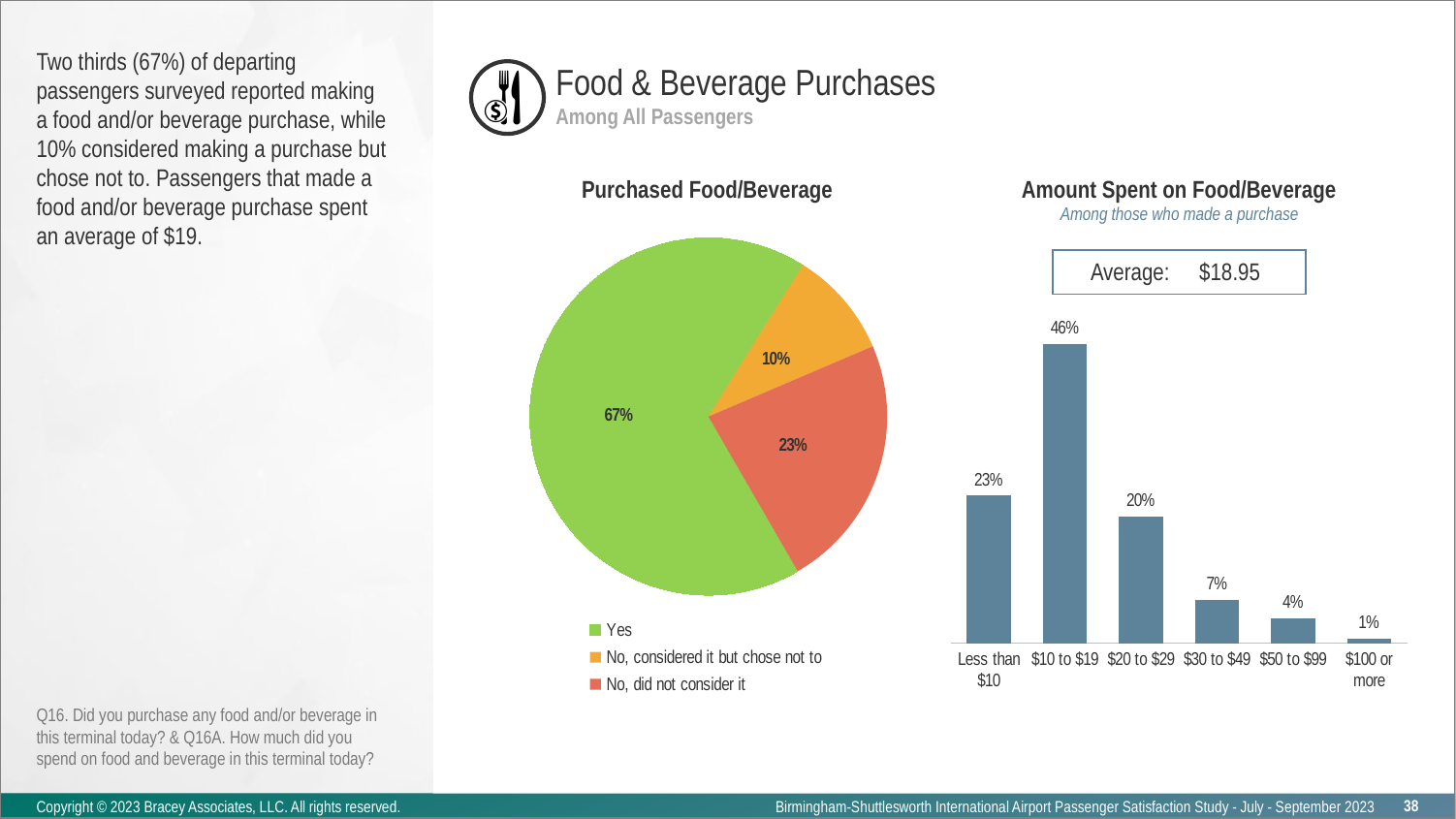
In the 'Amount Spent on Food/Beverage' chart, what is the value for '$30 to $49'? 7% In the 'Amount Spent on Food/Beverage' chart, what is the difference between 'Less than $10' and '$20 to $29'? 3% In the 'Amount Spent on Food/Beverage' chart, what is the value for '$10 to $19'? 46% How many entries does the legend of the 'Purchased Food/Beverage' chart list? 3 What kind of chart is the 'Purchased Food/Beverage' chart? Pie chart In the 'Amount Spent on Food/Beverage' chart, which category has the highest value? $10 to $19 What average amount is shown above the 'Amount Spent on Food/Beverage' chart? $18.95 In the 'Purchased Food/Beverage' chart, what share of passengers answered 'Yes'? 67% In the 'Amount Spent on Food/Beverage' chart, which category has the lowest value? $100 or more In the 'Purchased Food/Beverage' chart, what share answered 'No, did not consider it'? 23% In the 'Purchased Food/Beverage' chart, what share answered 'No, considered it but chose not to'? 10% How many categories are shown in the 'Amount Spent on Food/Beverage' chart? 6